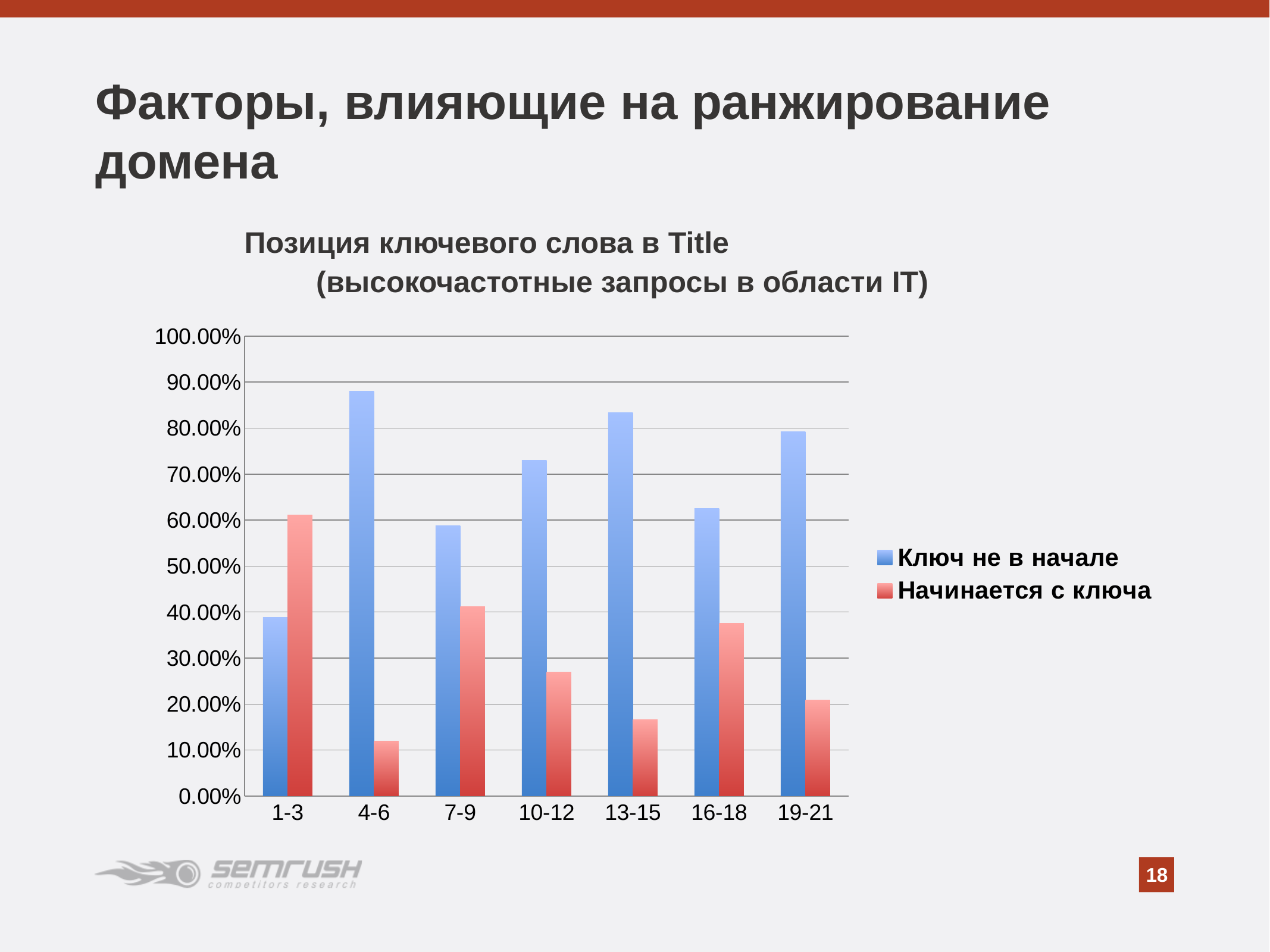
How many series does the legend list? 2 What kind of chart is shown on the slide? bar chart How many categories are shown on the x axis? 7 Which category has the lowest value for 'Начинается с ключа'? 4-6 For category 1-3, which series has the larger value: 'Ключ не в начале' or 'Начинается с ключа'? Начинается с ключа What colour are the bars for the series 'Начинается с ключа'? red Is the value for 'Ключ не в начале' at 4-6 greater or less than 80.00%? greater Is the value for 'Начинается с ключа' at 13-15 greater or less than 20.00%? less Which category has the highest value for 'Начинается с ключа'? 1-3 Which category has the lowest value for 'Ключ не в начале'? 1-3 Is the value for 'Ключ не в начале' at 10-12 greater or less than 70.00%? greater Which category has the highest value for 'Ключ не в начале'? 4-6